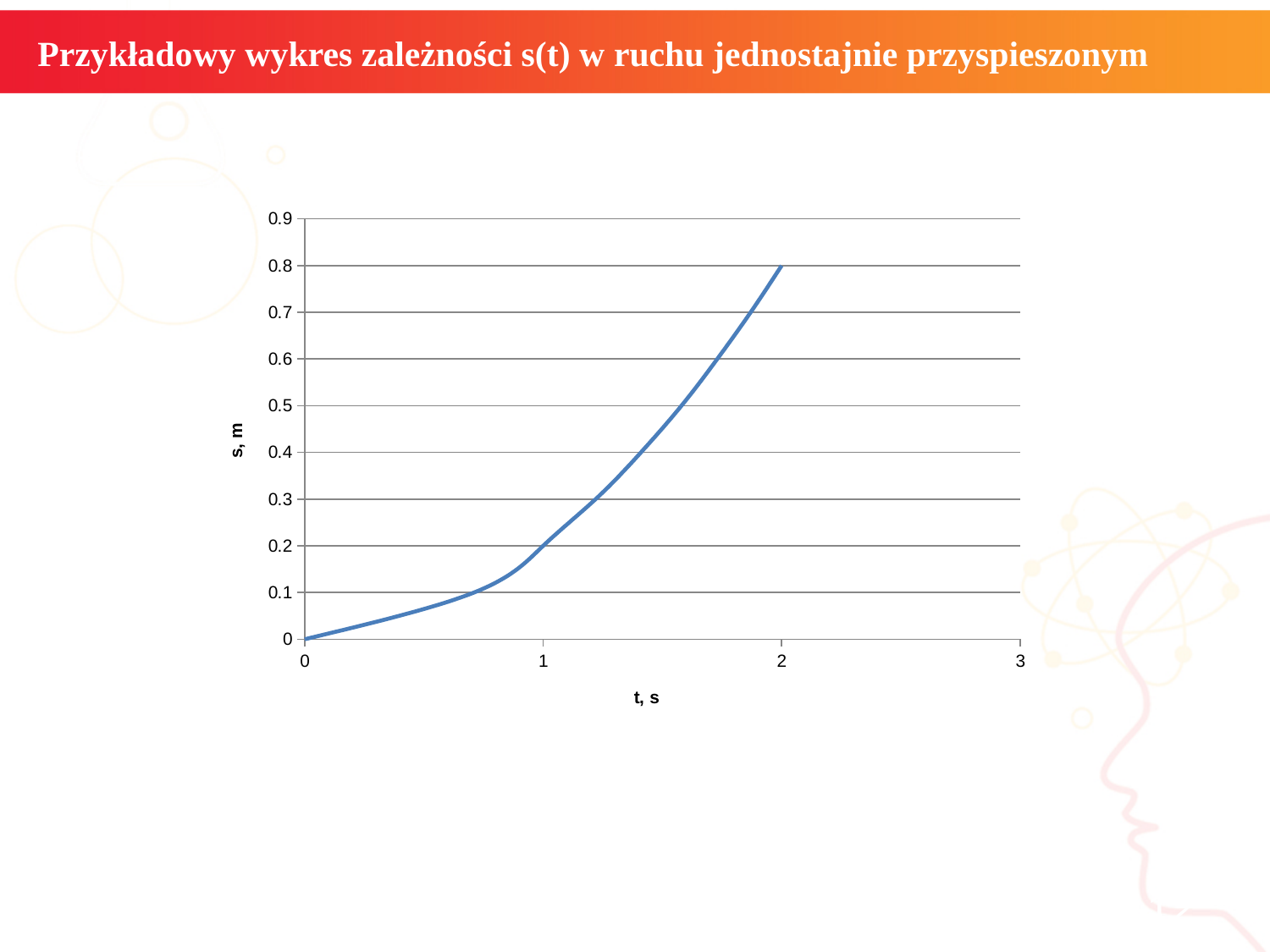
What is the value of s at t = 0 s? 0 What is the label of the horizontal axis? t, s What kind of chart is shown on the slide? line chart What is the value of s at t = 1 s? 0.2 What is the value of s at t = 2 s? 0.8 Is the value of s at t = 1.5 s greater or less than 0.3? greater Is the value of s at t = 1.8 s greater or less than 0.5? greater What is the highest tick value shown on the vertical axis? 0.9 What is the label of the vertical axis? s, m Is the value of s at t = 0.5 s greater or less than 0.1? less Does the value of s rise or fall as t increases along the x axis? rise At which plotted value of t does s reach its highest value? 2